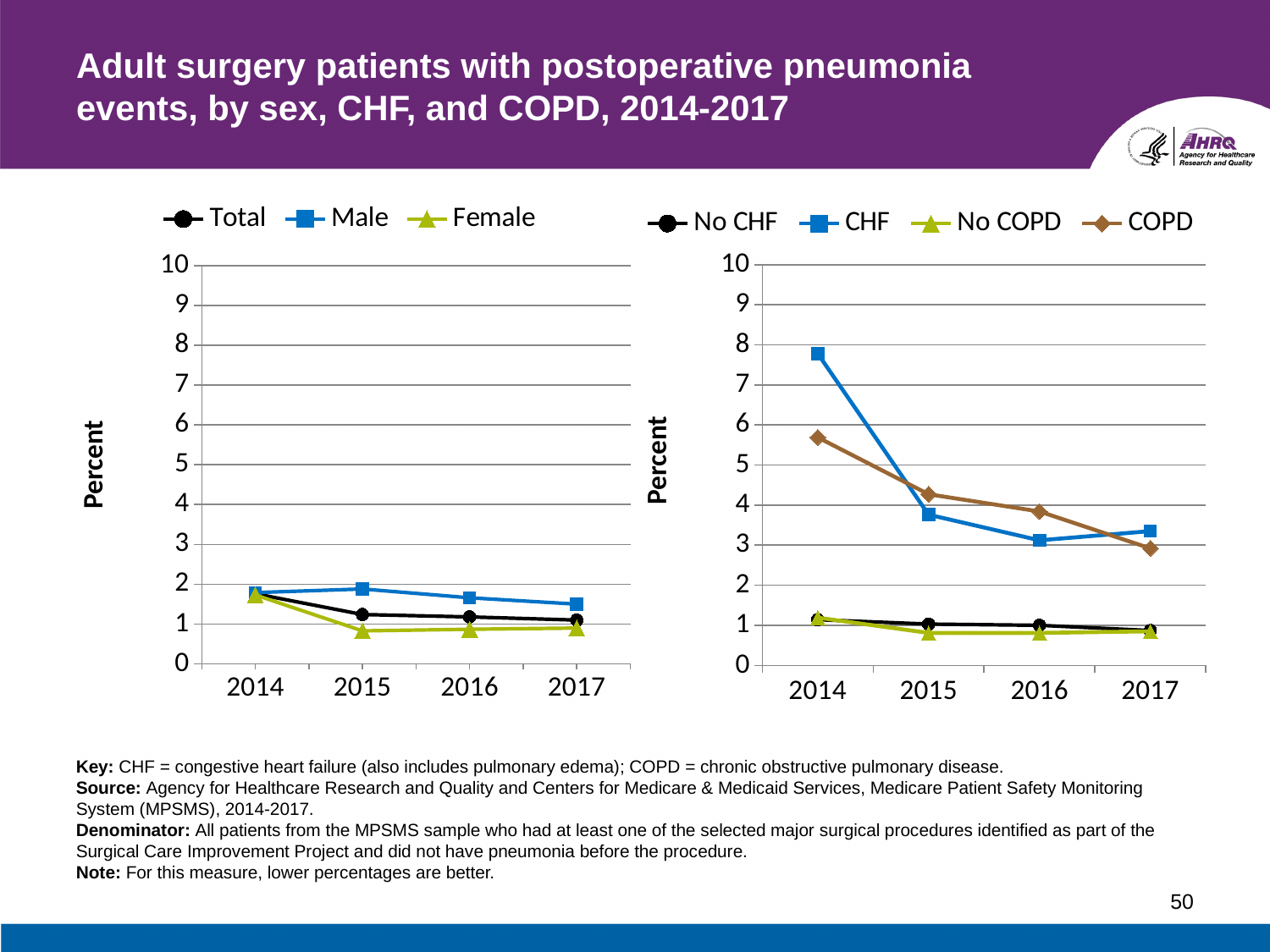
How many series does the legend of the left chart list? 3 In the right chart, is the value for COPD in 2014 greater or less than 5? greater In the left chart, which is larger in 2017, Male or Female? Male In the right chart, which series has the highest value in 2014? CHF What is the label on the y axis of the left chart? Percent In the right chart, does the CHF series rise or fall from 2014 to 2017? fall What kind of chart is the left chart (Total, Male, Female)? line chart In the left chart, is the value for Female in 2015 greater or less than 1? less In the right chart, is the value for CHF in 2017 greater or less than 4? less How many series does the legend of the right chart (No CHF, CHF, No COPD, COPD) list? 4 How many years are shown on the x axis of the right chart? 4